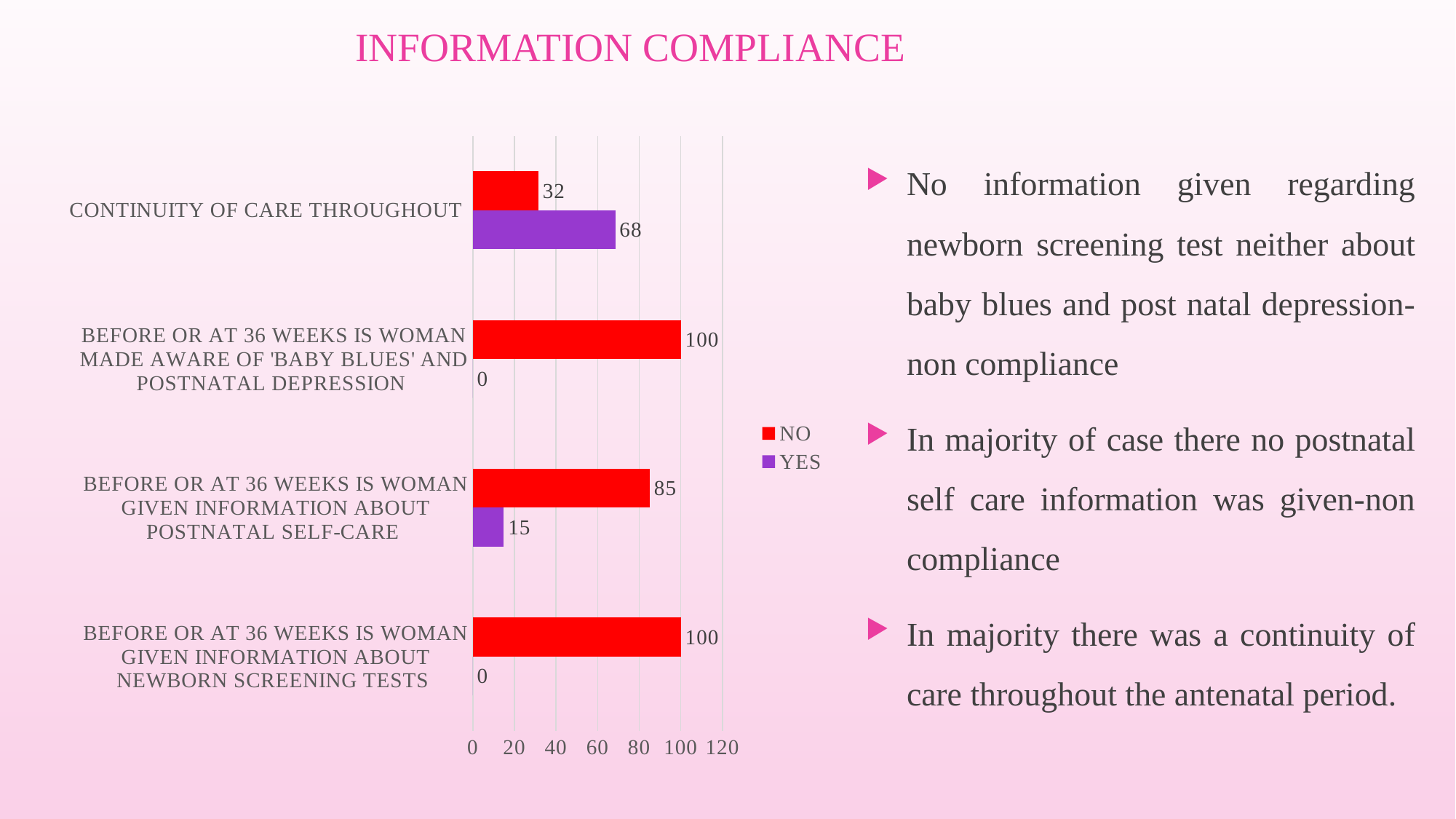
What is the YES value for 'Continuity of care throughout'? 68 What is the NO value for 'Continuity of care throughout'? 32 For 'Continuity of care throughout', which is larger, the YES value or the NO value? YES Which category has the highest YES value? Continuity of care throughout What colour represents the YES series in the chart? Purple What is the YES value for 'Before or at 36 weeks is woman given information about postnatal self-care'? 15 How many series does the legend list? 2 What is the difference between the NO and YES values for 'Before or at 36 weeks is woman given information about postnatal self-care'? 70 What is the NO value for 'Before or at 36 weeks is woman given information about newborn screening tests'? 100 How many categories are shown on the chart? 4 What kind of chart is shown on the slide? Bar chart Which category has the lowest NO value? Continuity of care throughout